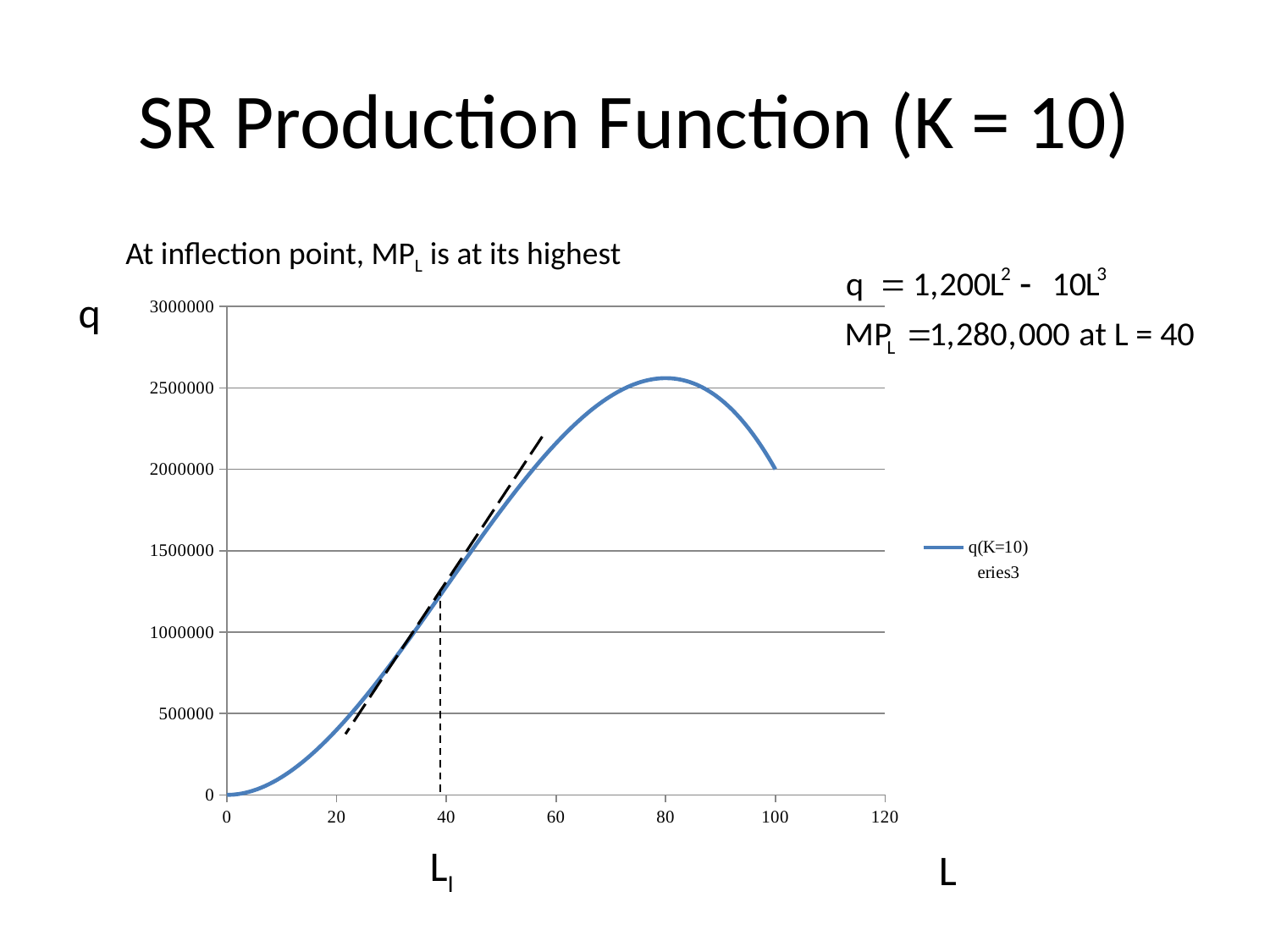
What is the value of q(K=10) at L = 0? 0 Does the q(K=10) curve rise or fall as L increases from 80 to 100? fall Is the value of q(K=10) at L = 60 greater or less than 2000000? greater What is the highest tick value shown on the vertical axis? 3000000 What kind of chart is shown on the slide? line chart Is the value of q(K=10) at L = 20 greater or less than 500000? less What is the name of the first series in the legend? q(K=10) At which value of L does the q(K=10) curve reach its highest point? 80 Does the q(K=10) curve rise or fall as L increases from 0 to 60? rise What is the value of q(K=10) at L = 100? 2000000 Which is larger, q(K=10) at L = 40 or at L = 80? L = 80 How many series does the legend list? 2